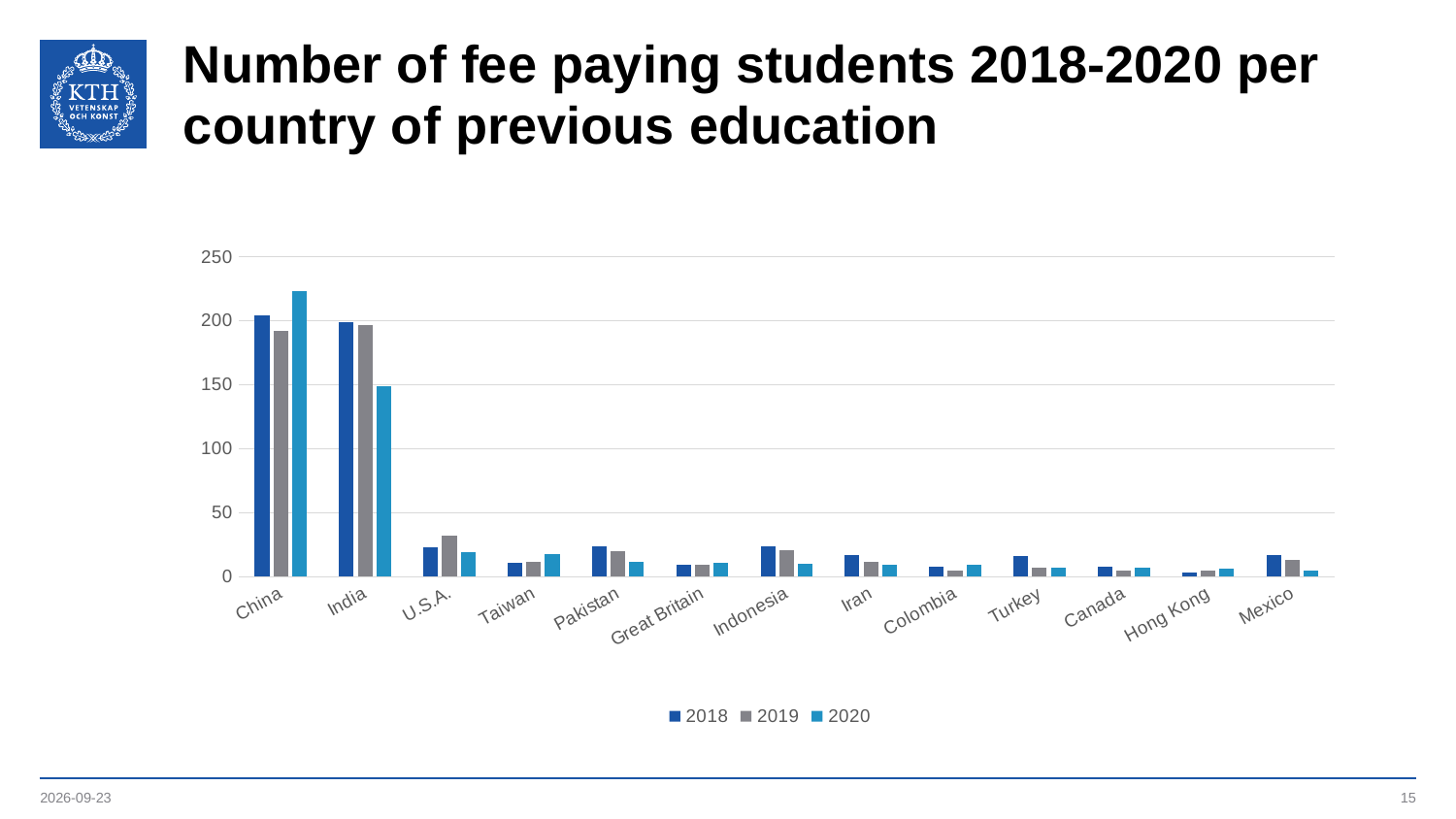
Is the value for China in 2020 greater or less than 200? greater Do the values for India rise or fall from 2018 to 2020? fall How many countries are shown on the x axis? 13 What are the three entries in the chart legend? 2018, 2019, 2020 Which country has the lowest value for 2018? Hong Kong Which is larger, the 2018 value for U.S.A. or the 2019 value for U.S.A.? 2019 Which is larger, the 2020 value for China or the 2020 value for India? China What kind of chart is shown on the slide? Bar chart Is the value for U.S.A. in 2019 greater or less than 50? less Which country has the highest value for 2020? China How many series does the legend list? 3 Is the value for India in 2020 greater or less than 100? greater